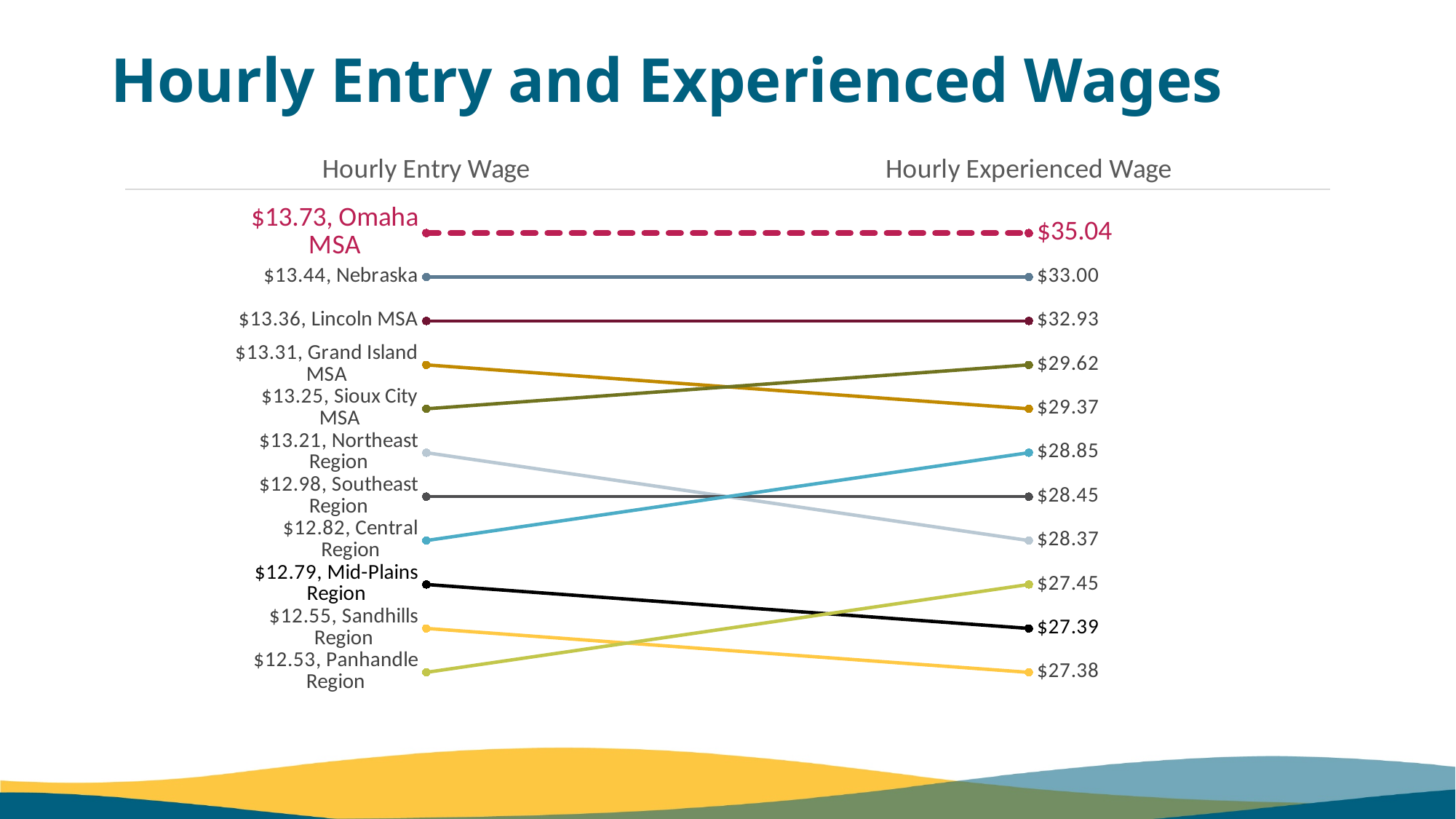
What is the hourly entry wage for the Panhandle Region? $12.53 Which has the higher hourly entry wage, Lincoln MSA or Grand Island MSA? Lincoln MSA What is the hourly experienced wage for Omaha MSA? $35.04 How many areas (lines) are plotted on the chart? 11 Which area's line is drawn as a dashed line? Omaha MSA Which area has the highest hourly experienced wage? Omaha MSA What kind of chart is shown on the slide? Line chart Which area has the lowest hourly entry wage? Panhandle Region What is the difference between the hourly experienced wage and the hourly entry wage for Nebraska? $19.56 What are the two x-axis categories on the chart? Hourly Entry Wage and Hourly Experienced Wage What is the hourly experienced wage for Nebraska? $33.00 What is the hourly entry wage for Omaha MSA? $13.73